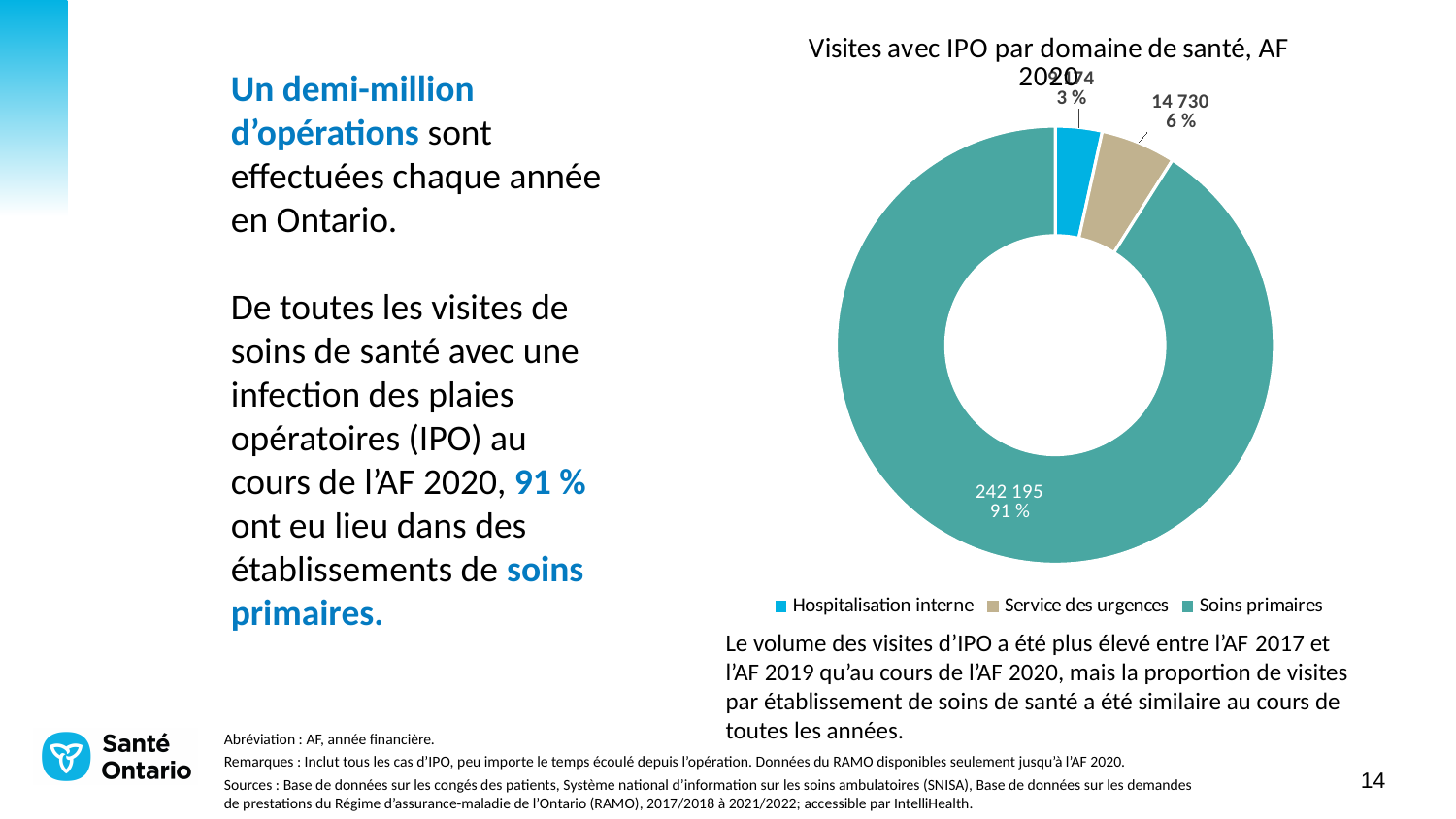
Which category has the smallest share of visits in the chart? Hospitalisation interne How many categories does the legend of the chart list? 3 What is the number of visits for Service des urgences? 14 730 What kind of chart is shown on the slide? Pie chart (donut) What is the title of the chart? Visites avec IPO par domaine de santé, AF 2020 What percentage of visits does Soins primaires represent? 91 % What is the difference in visits between Soins primaires and Service des urgences? 227 465 What is the number of visits for Soins primaires? 242 195 Which category has the largest share of visits in the chart? Soins primaires Which has more visits, Service des urgences or Hospitalisation interne? Service des urgences What percentage of visits does Service des urgences represent? 6 % What percentage of visits does Hospitalisation interne represent? 3 %